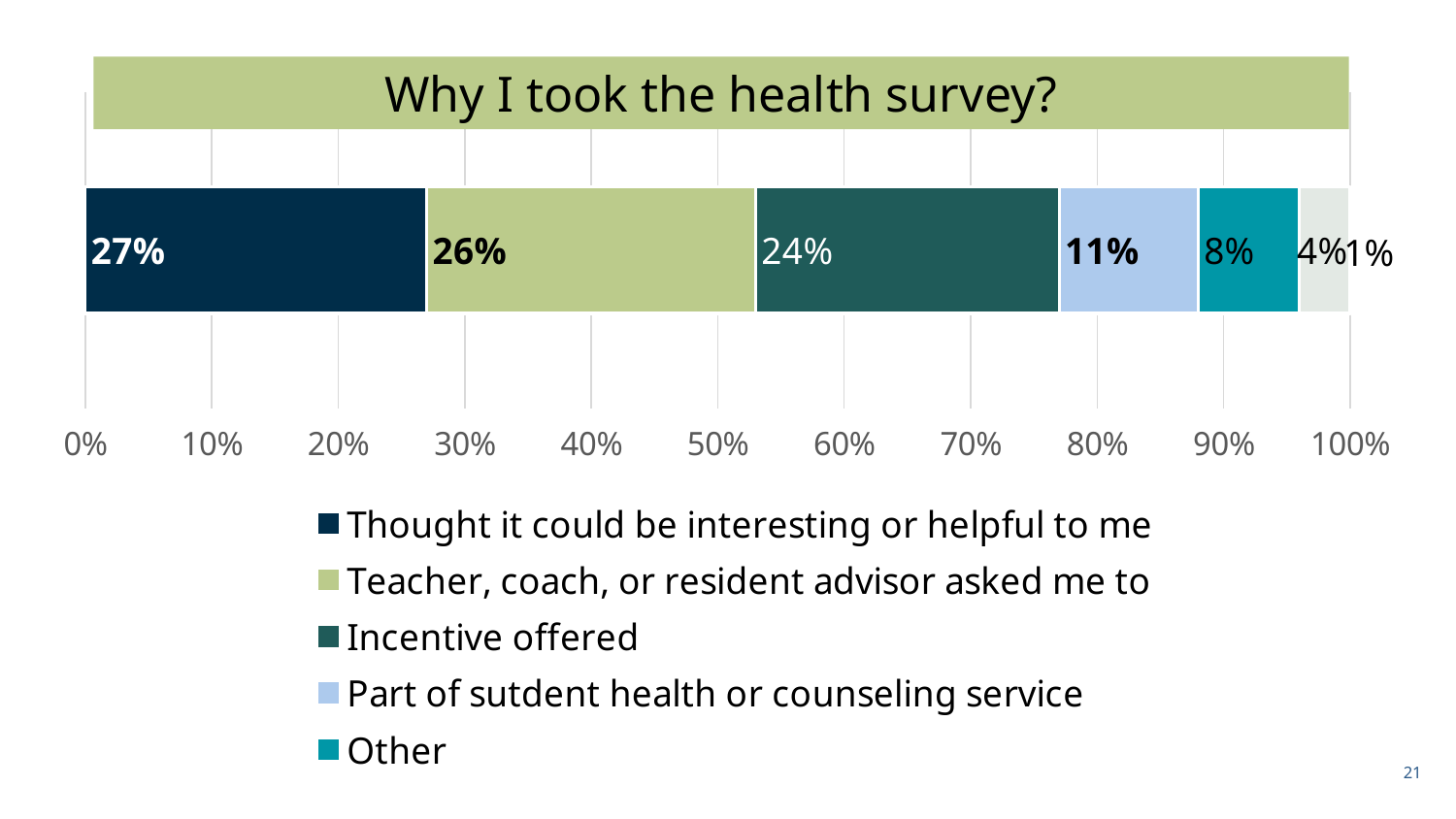
What is the value for the 'Other' category? 8% What percentage took the survey because a teacher, coach, or resident advisor asked them to? 26% What is the difference between the 'Thought it could be interesting or helpful to me' value and the 'Part of sutdent health or counseling service' value? 16% Which reason listed in the legend has the lowest percentage? Other What is the value shown for 'Incentive offered'? 24% Which is larger: 'Incentive offered' or 'Other'? Incentive offered What type of chart is shown on the slide? Stacked bar chart How many entries does the legend list? 5 Which reason listed in the legend has the highest percentage? Thought it could be interesting or helpful to me What percentage of respondents said they took the health survey because they thought it could be interesting or helpful to them? 27% What percentage is shown for 'Part of sutdent health or counseling service'? 11% What is the title of the chart? Why I took the health survey?